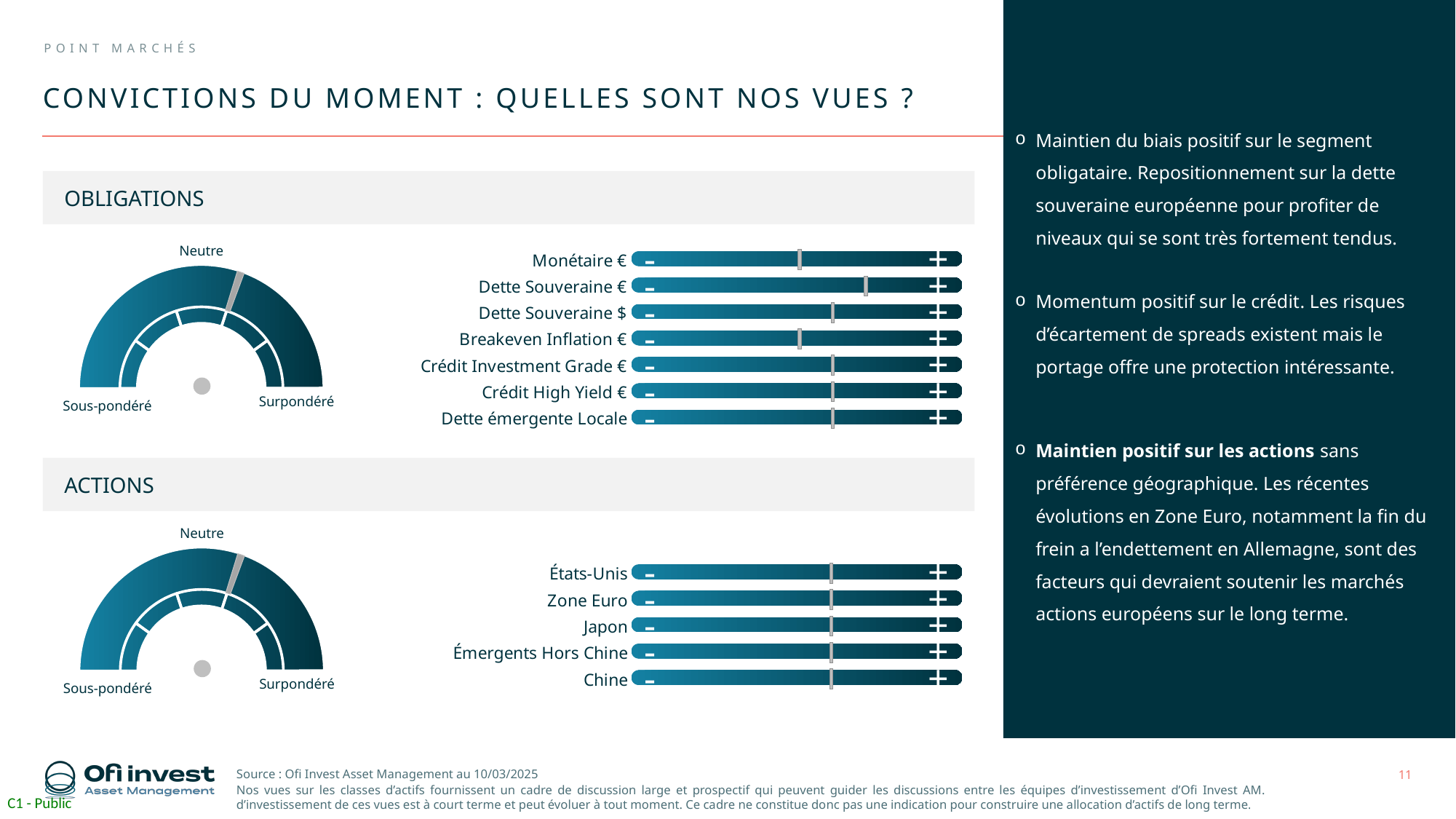
How many regions are listed with sliders in the ACTIONS section? 5 What kind of chart is used on the left of each section to show the overall positioning? Gauge chart Which region is listed first in the ACTIONS slider list? États-Unis What are the two section headings above the charts on the slide? OBLIGATIONS and ACTIONS In the OBLIGATIONS section, which asset class has its slider marker positioned furthest toward the '+' end? Dette Souveraine € Does the needle of the OBLIGATIONS gauge point toward Sous-pondéré or Surpondéré? Surpondéré Does the needle of the ACTIONS gauge point toward Sous-pondéré or Surpondéré? Surpondéré In the OBLIGATIONS section, is the slider marker for Dette Souveraine € further toward '+' than the marker for Monétaire €? Yes, Dette Souveraine € How many asset classes are listed with sliders in the OBLIGATIONS section? 7 Which asset class is listed last in the OBLIGATIONS slider list? Dette émergente Locale What label appears at the top centre of each gauge? Neutre In the OBLIGATIONS section, which slider marker is further toward '+': Crédit High Yield € or Breakeven Inflation €? Crédit High Yield €